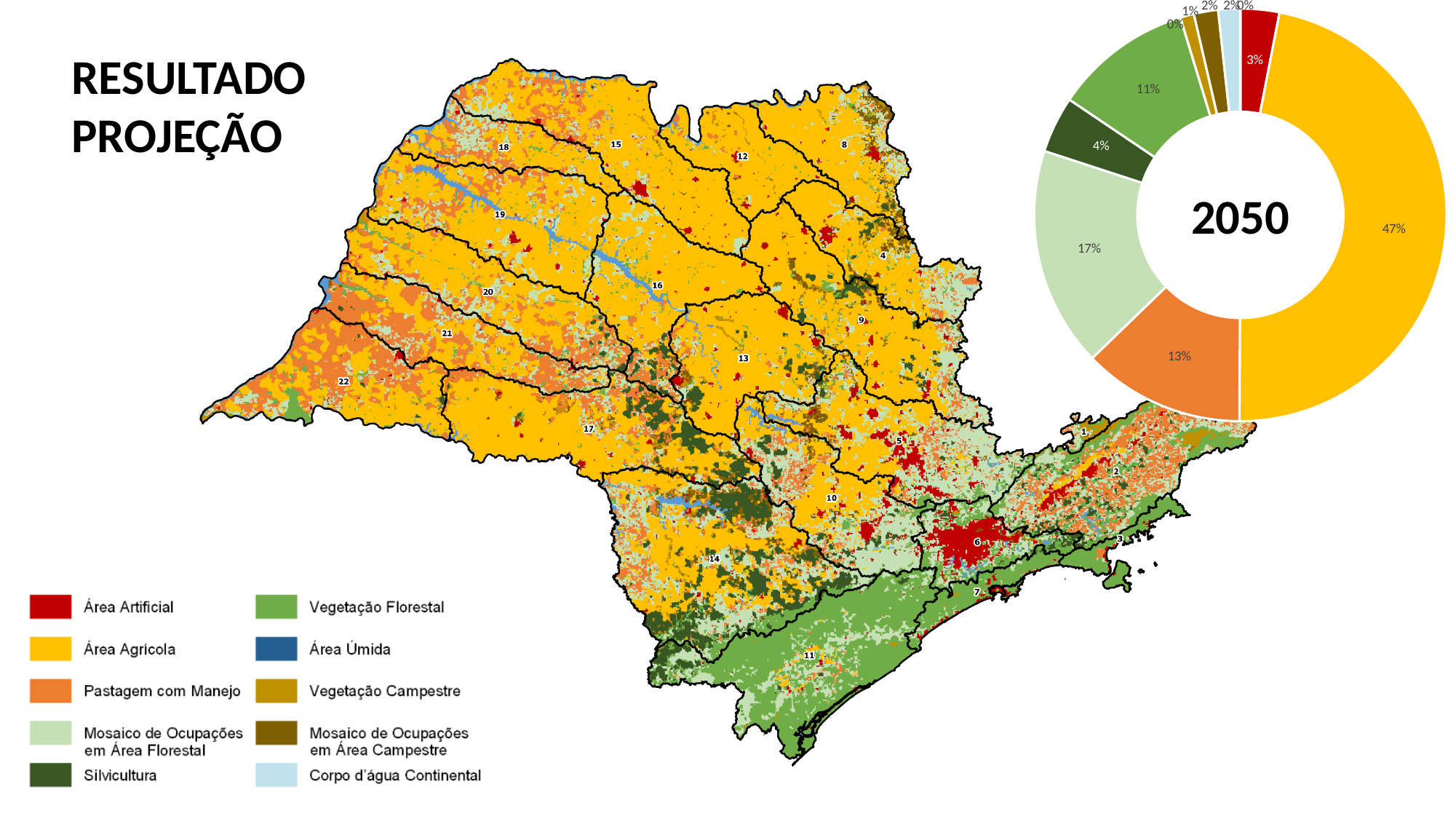
What share does the orange slice (Pastagem com Manejo) have in the donut chart? 13% What share does the medium green slice (Vegetação Florestal) have in the donut chart? 11% What year is printed in the centre of the donut chart? 2050 What is the largest share shown in the donut chart? 47% In the donut chart, how many percentage points larger is the yellow slice (47%) than the orange slice (13%)? 34 percentage points In the donut chart, which is larger: the light green slice (Mosaico de Ocupações em Área Florestal) or the orange slice (Pastagem com Manejo)? The light green slice (17%) What share does the dark green slice (Silvicultura) have in the donut chart? 4% In the donut chart, what is the difference between the light green slice (17%) and the medium green slice (11%)? 6 percentage points What kind of chart is shown on the right side of the slide? A donut (pie) chart